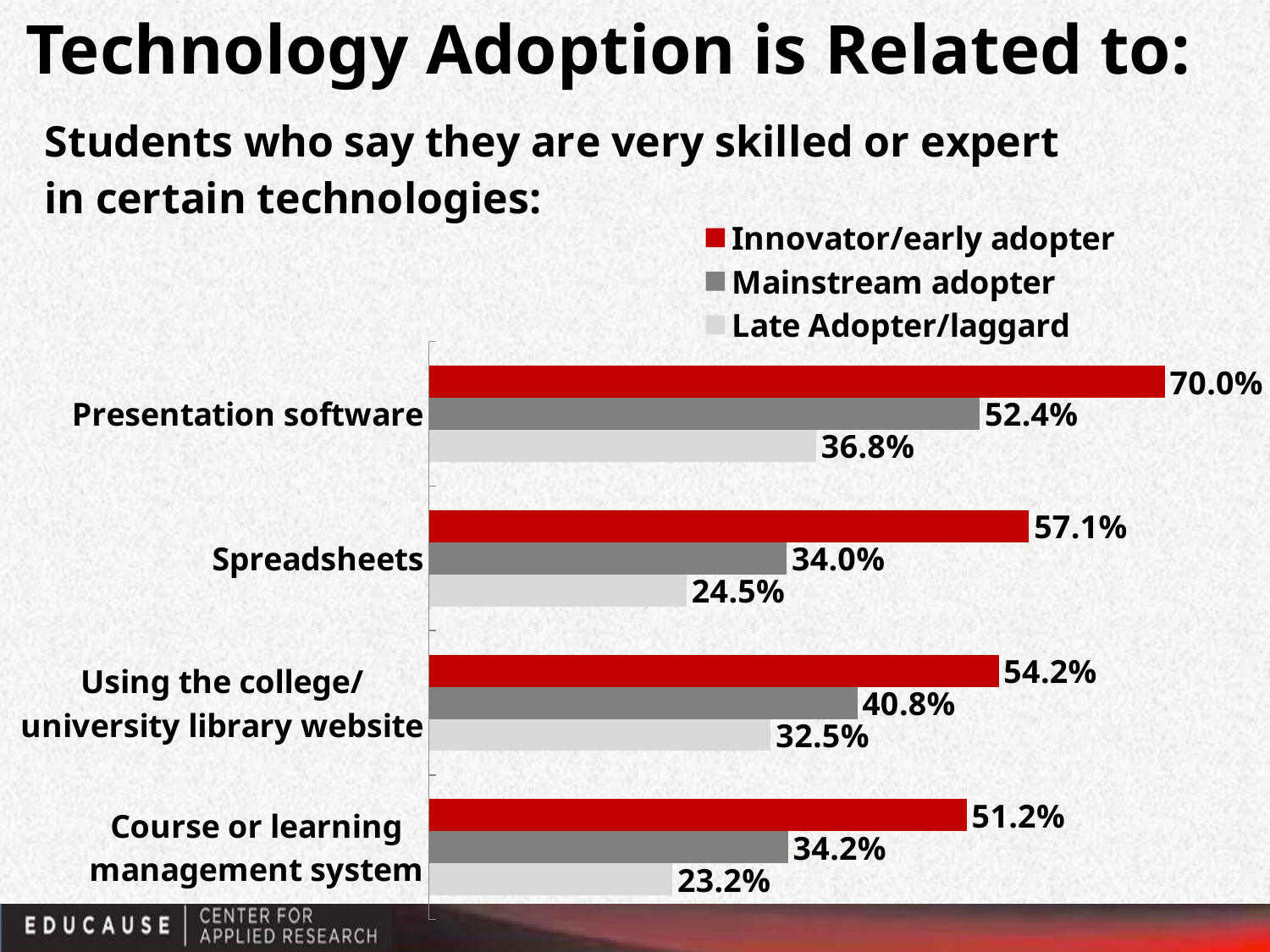
How many series does the legend list? 3 What is the Mainstream adopter value for Using the college/university library website? 40.8% Which technology has the lowest Late Adopter/laggard value? Course or learning management system Which colour represents the Mainstream adopter series? Grey What percentage of Innovator/early adopters say they are very skilled or expert in Presentation software? 70.0% What kind of chart is shown on the slide? Bar chart What is the difference between the Mainstream adopter values for Spreadsheets and Course or learning management system? 0.2% Which is larger: the Innovator/early adopter value for Spreadsheets or for Using the college/university library website? Spreadsheets Which technology has the highest Innovator/early adopter value? Presentation software How many technology categories are shown in the chart? 4 What is the difference between the Innovator/early adopter and Late Adopter/laggard values for Presentation software? 33.2% What is the value for Late Adopter/laggard for Spreadsheets? 24.5%